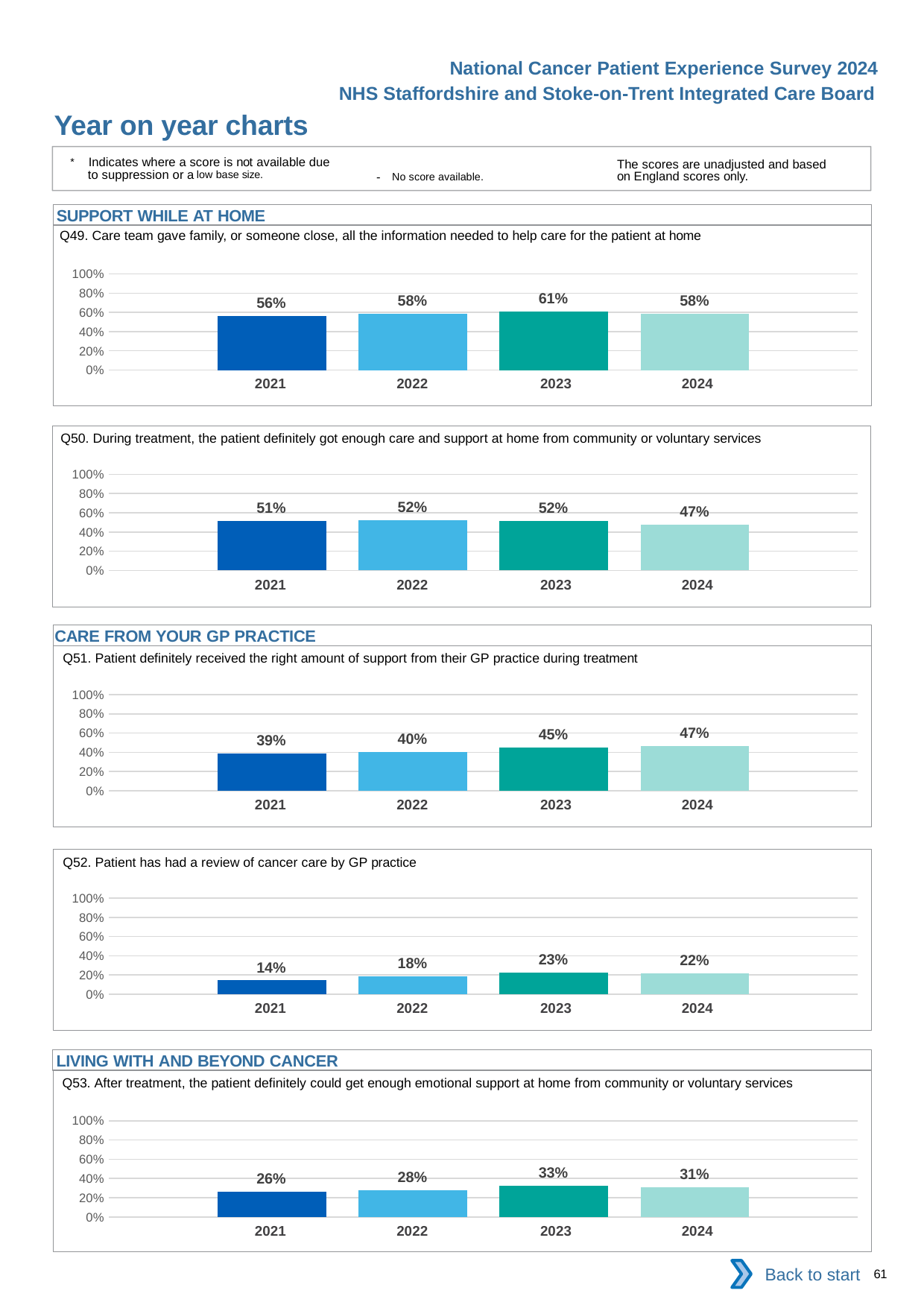
In the Q52 chart, which year has the highest value? 2023 In the Q53 chart, what is the value for 2022? 28% In the Q51 chart, do the values rise or fall from 2021 to 2024? Rise In the Q53 chart, what is the difference between the 2023 and 2024 values? 2% In the Q52 chart, is the value for 2021 greater or less than 20%? less In the Q49 chart, what is the value for 2023? 61% In the Q50 chart, which year has the lowest value? 2024 In the Q51 chart, is the value for 2023 larger than the value for 2022? Yes What kind of chart is the Q50 chart? Bar chart Which section heading appears above the Q53 chart? LIVING WITH AND BEYOND CANCER In the Q51 chart, what is the difference between the 2024 and 2021 values? 8% In the Q49 chart, how many years are shown on the x axis? 4